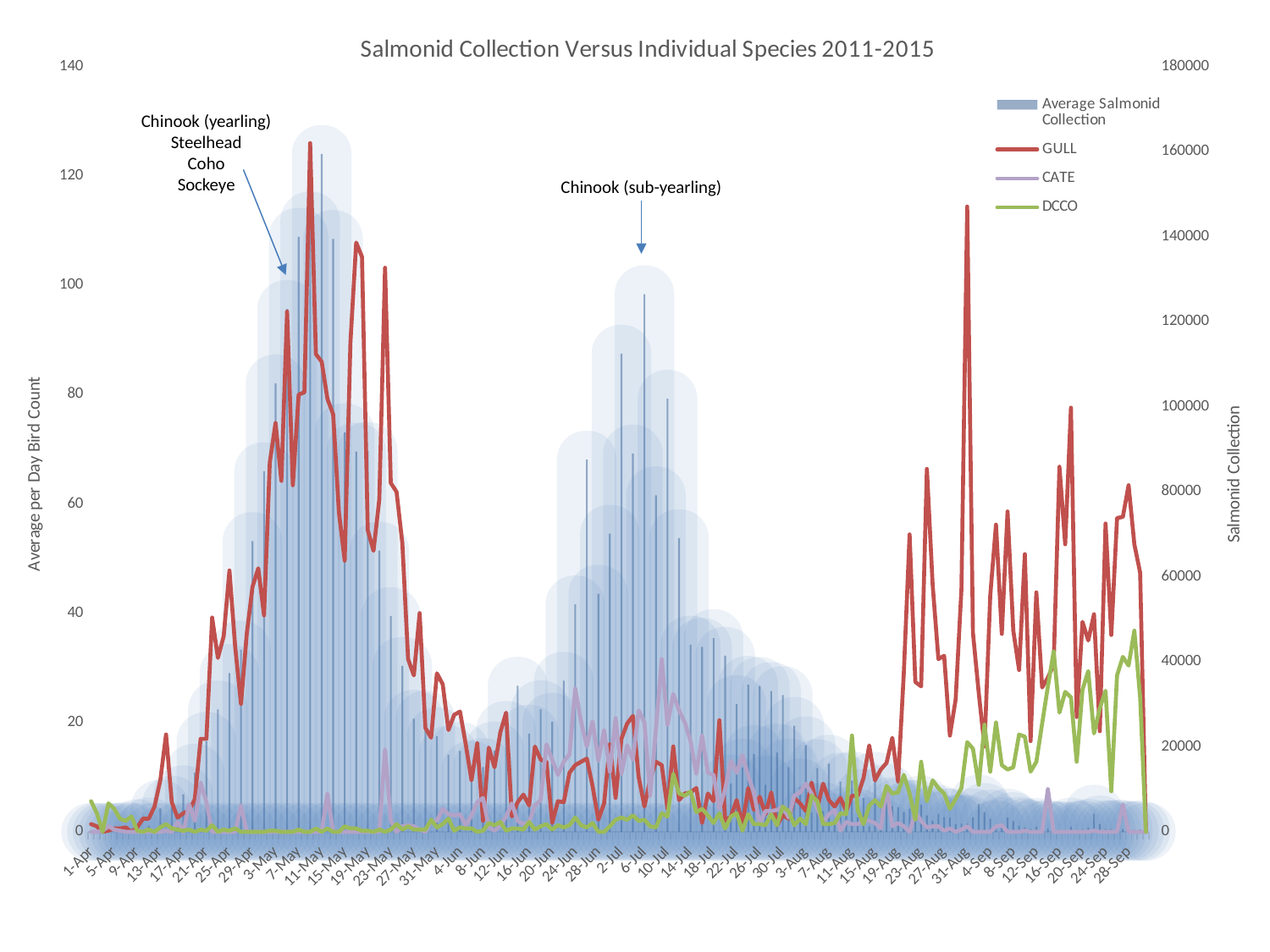
Does the GULL series rise or fall between 1-Apr and 9-May? rise Does the DCCO series rise or fall between 15-Aug and 24-Sep? rise What kind of chart is this? Combined bar and line chart Is the highest value of the DCCO series greater or less than 60? less What is the title of the chart? Salmonid Collection Versus Individual Species 2011-2015 Which line series reaches the highest value on the chart? GULL Is the tallest Average Salmonid Collection bar greater or less than 140000? greater Which species is annotated at the second peak of the Average Salmonid Collection bars in early July? Chinook (sub-yearling) Is the highest value of the CATE series greater or less than 40? less What is the label of the left vertical axis? Average per Day Bird Count How many series does the chart's legend list? 4